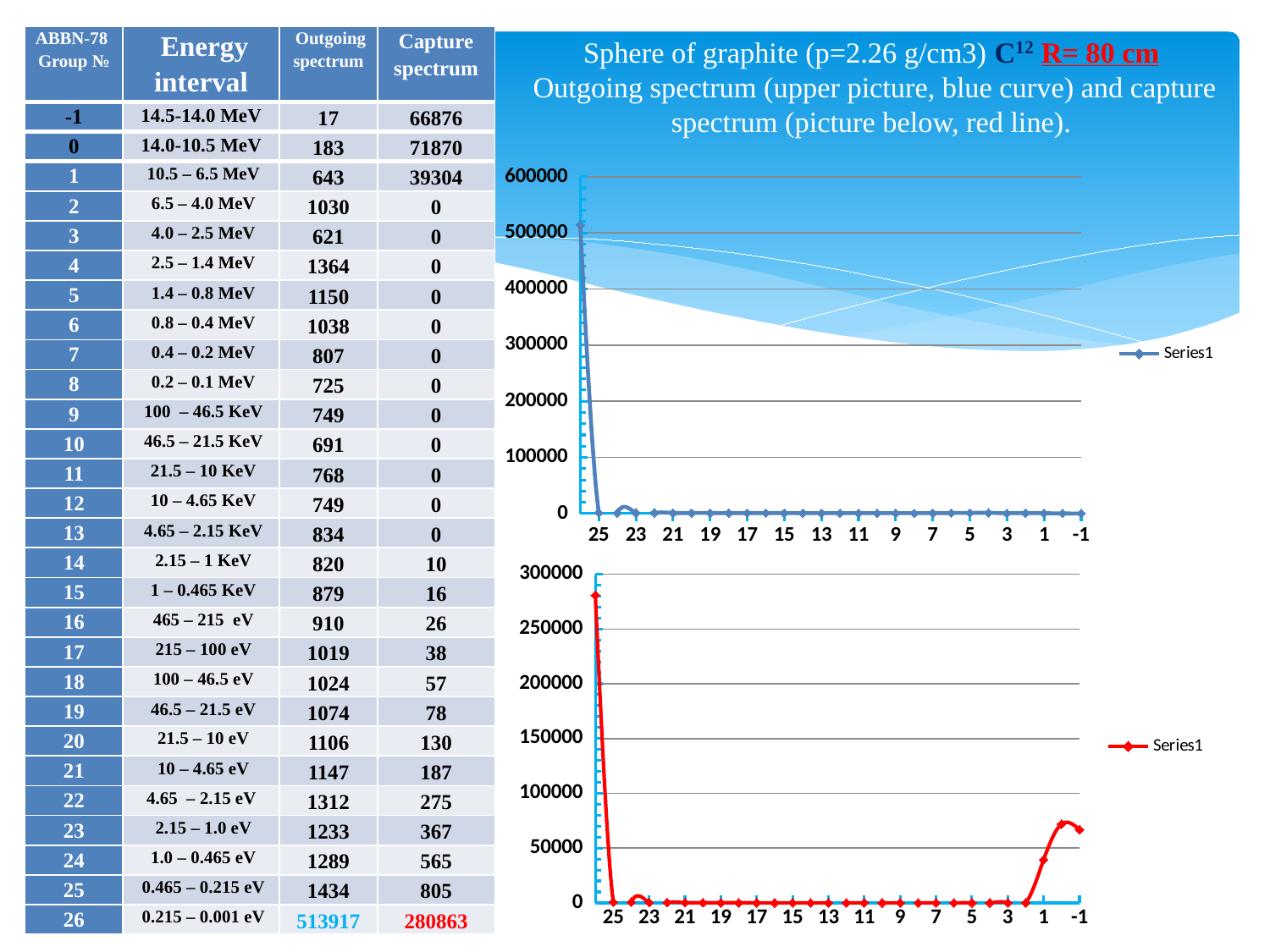
In the lower chart, is the value at group -1 greater or less than 100000? less In the upper chart, is the value at group 25 greater or less than 500000? less What kind of chart is the upper chart on the slide? line chart In the lower chart, at which x-axis group is the value highest? 26 In the lower chart, is the value at group 25 greater or less than 250000? less What is the legend entry shown for the lower chart? Series1 How many series does the legend of the upper chart list? 1 What kind of chart is the lower chart on the slide? line chart In the upper chart, at which x-axis group is the value highest? 26 In the lower chart, which is larger: the value at group 25 or the value at group -1? group -1